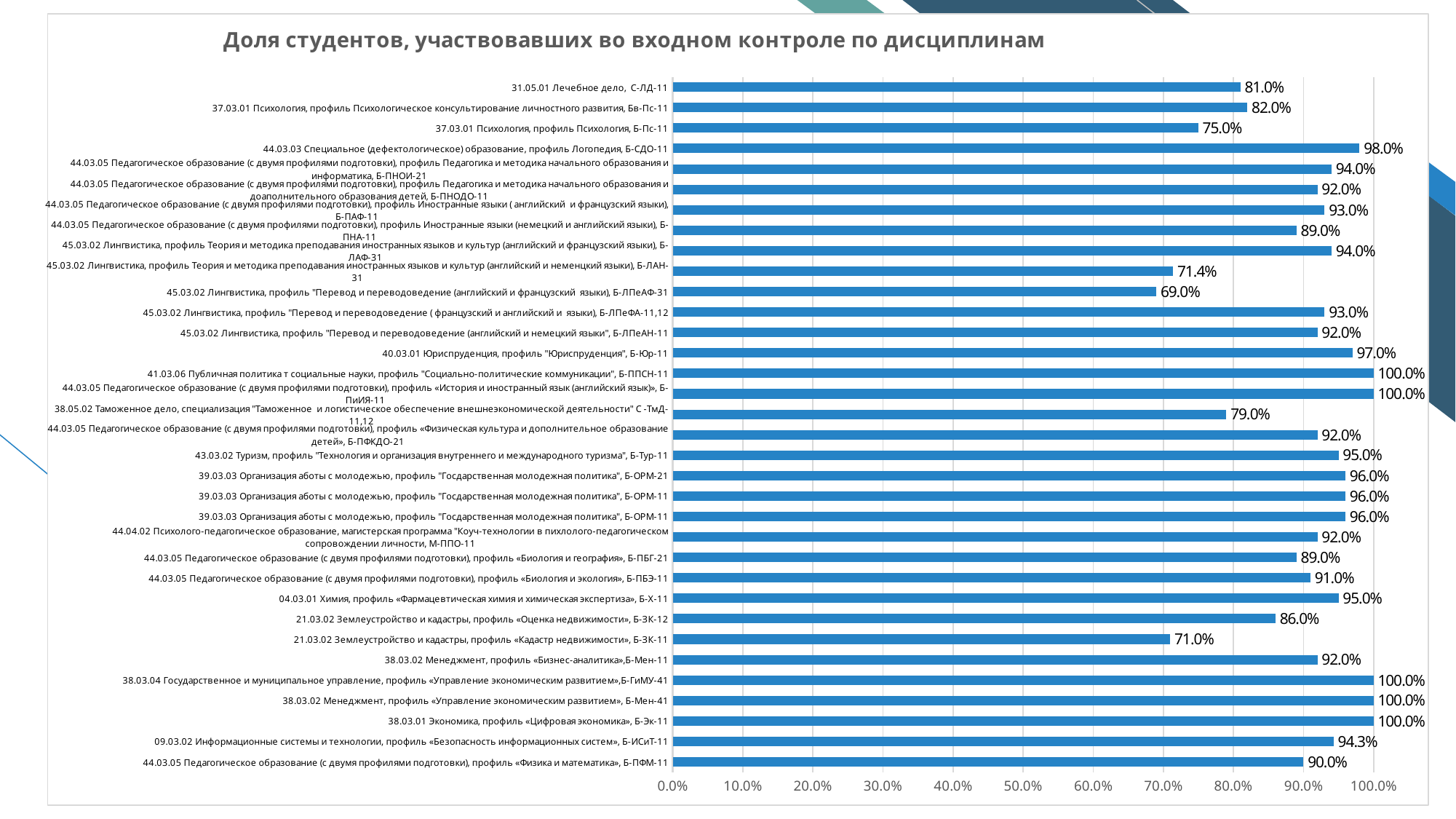
Is the value for 45.03.02 Лингвистика, профиль Теория и методика преподавания иностранных языков и культур (английский и неменцкий языки), Б-ЛАН-31 greater or less than 80.0%? less What is the value for 09.03.02 Информационные системы и технологии, профиль «Безопасность информационных систем», Б-ИСиТ-11? 94.3% What is the highest value shown on the chart? 100.0% What kind of chart is shown on the slide? bar chart Which is larger: the value for 37.03.01 Психология, профиль Психология, Б-Пс-11 or the value for 40.03.01 Юриспруденция, профиль "Юриспруденция", Б-Юр-11? 40.03.01 Юриспруденция, профиль "Юриспруденция", Б-Юр-11 What is the value for 38.05.02 Таможенное дело, специализация "Таможенное и логистическое обеспечение внешнеэкономической деятельности", С-ТмД-11,12? 79.0% Which category has the lowest value? 45.03.02 Лингвистика, профиль "Перевод и переводоведение (английский и французский языки), Б-ЛПеАФ-31 What is the title of the chart? Доля студентов, участвовавших во входном контроле по дисциплинам What is the value for 44.03.03 Специальное (дефектологическое) образование, профиль Логопедия, Б-СДО-11? 98.0% What is the value for 31.05.01 Лечебное дело, С-ЛД-11? 81.0% What is the difference between the values for 21.03.02 Землеустройство и кадастры, профиль «Оценка недвижимости», Б-ЗК-12 and 21.03.02 Землеустройство и кадастры, профиль «Кадастр недвижимости», Б-ЗК-11? 15.0% How many categories are plotted on the chart? 34